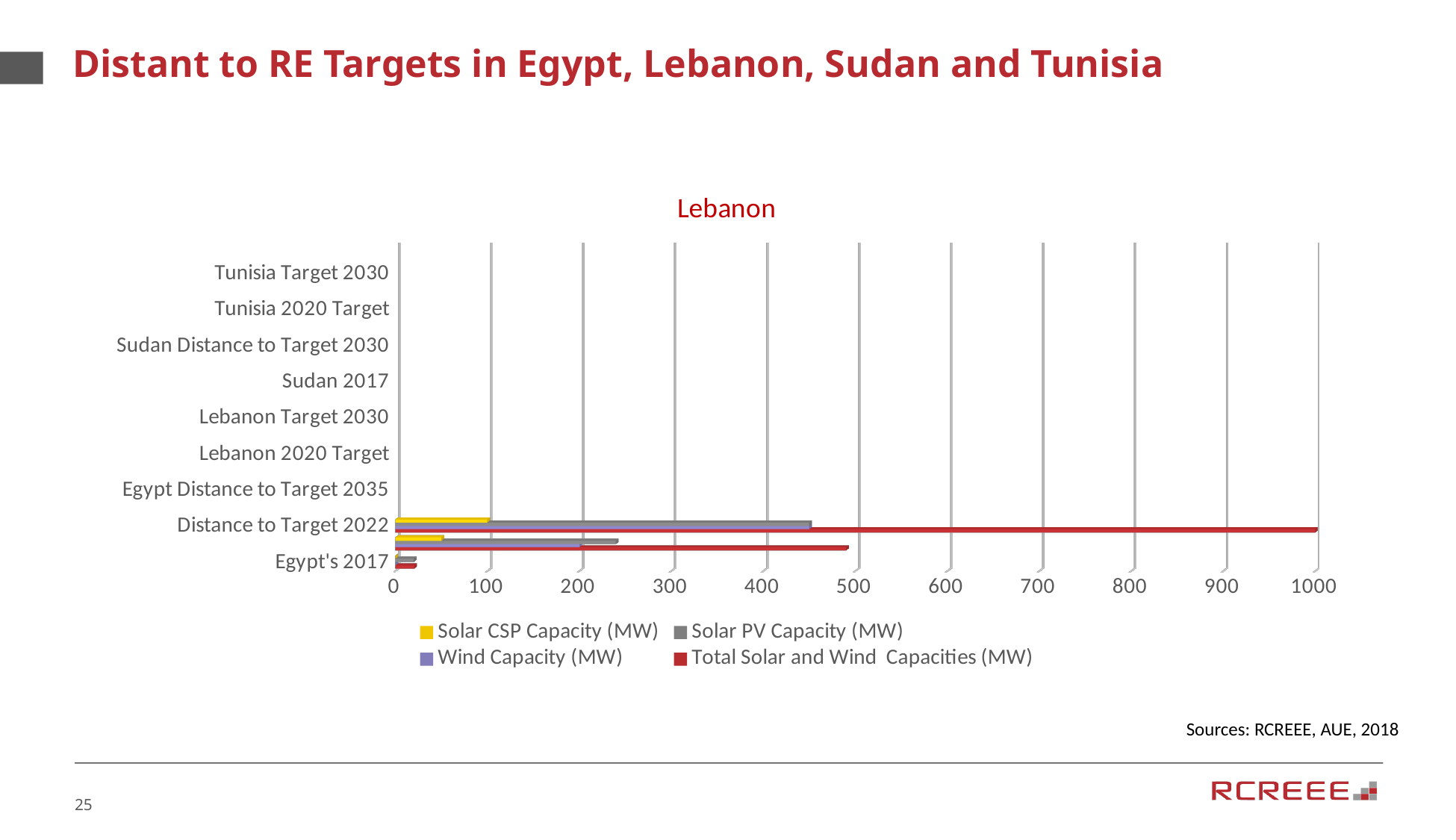
Is the Solar CSP Capacity (MW) value for Distance to Target 2022 greater or less than 200? less For Distance to Target 2022, which series has the lowest value? Solar CSP Capacity (MW) For Distance to Target 2022, which series has the highest value? Total Solar and Wind Capacities (MW) How many categories are labelled on the vertical axis of the chart? 9 What kind of chart is shown on the slide? bar chart Is the Wind Capacity (MW) value for Distance to Target 2022 greater or less than 500? less What is the title of the chart? Lebanon For Distance to Target 2022, which is larger: Solar PV Capacity (MW) or Solar CSP Capacity (MW)? Solar PV Capacity (MW) Is the Solar PV Capacity (MW) value for Distance to Target 2022 greater or less than 400? greater How many series does the legend list? 4